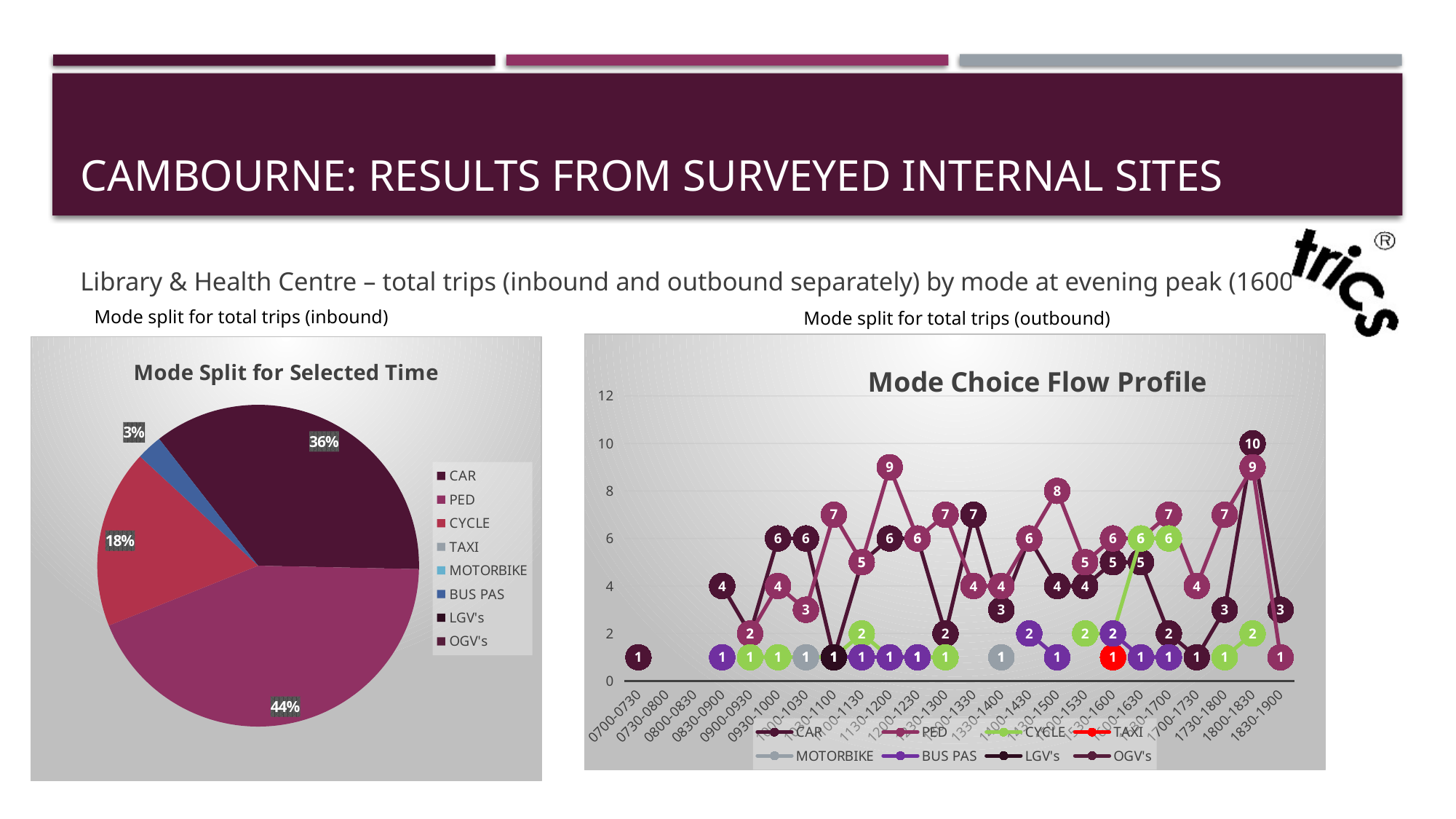
In the 'Mode Split for Selected Time' pie chart, which is larger, the CAR share or the CYCLE share? CAR How many entries does the legend of the 'Mode Split for Selected Time' pie chart list? 8 In the 'Mode Split for Selected Time' pie chart, what share of inbound trips is by CAR? 36% What kind of chart is the 'Mode Choice Flow Profile' chart? Line chart What is the highest data label value shown on the 'Mode Choice Flow Profile' chart? 10 In the 'Mode Split for Selected Time' pie chart, which mode has the largest share? PED In the 'Mode Split for Selected Time' pie chart, what share of inbound trips is by BUS PAS? 3% How many series does the legend of the 'Mode Choice Flow Profile' chart list? 8 In the 'Mode Split for Selected Time' pie chart, what share of inbound trips is by CYCLE? 18% In the 'Mode Split for Selected Time' pie chart, what is the difference between the PED share and the CAR share? 8% In the 'Mode Split for Selected Time' pie chart, what share of inbound trips is by PED? 44% In the 'Mode Split for Selected Time' pie chart, which of the labelled slices has the smallest share? BUS PAS